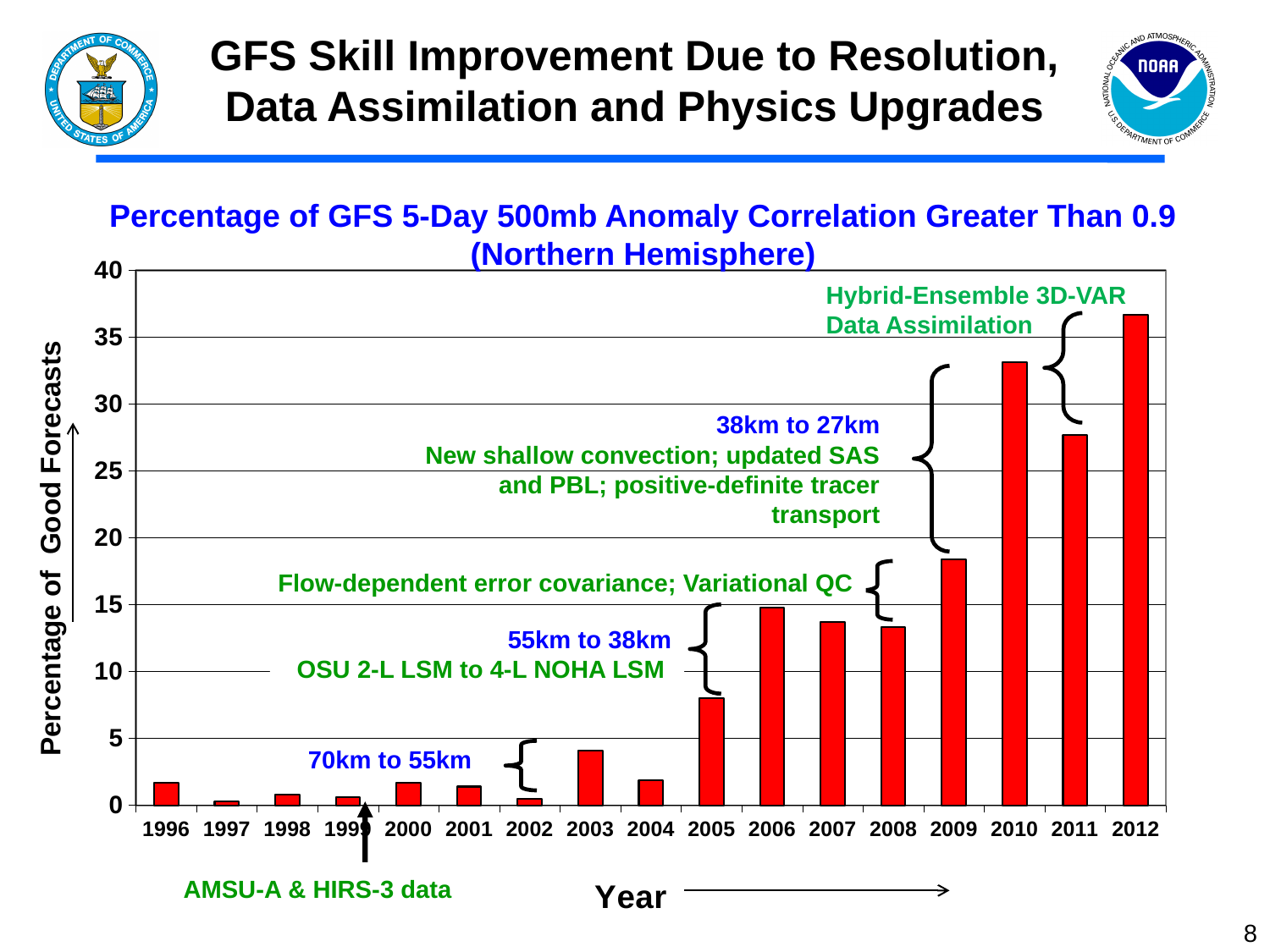
Which year has the larger value, 2010 or 2011? 2010 What is the label of the x axis? Year Which year has the highest percentage of good forecasts? 2012 Is the value for 2005 greater or less than 10? less Is the value for 2010 greater or less than 30? greater Is the value for 2009 greater or less than 20? less What colour are the bars in the chart? red Which year has the larger value, 2005 or 2006? 2006 How many years are plotted along the x axis of the chart? 17 Overall, do the values rise or fall from 1996 to 2012? rise What kind of chart is shown on the slide? bar chart